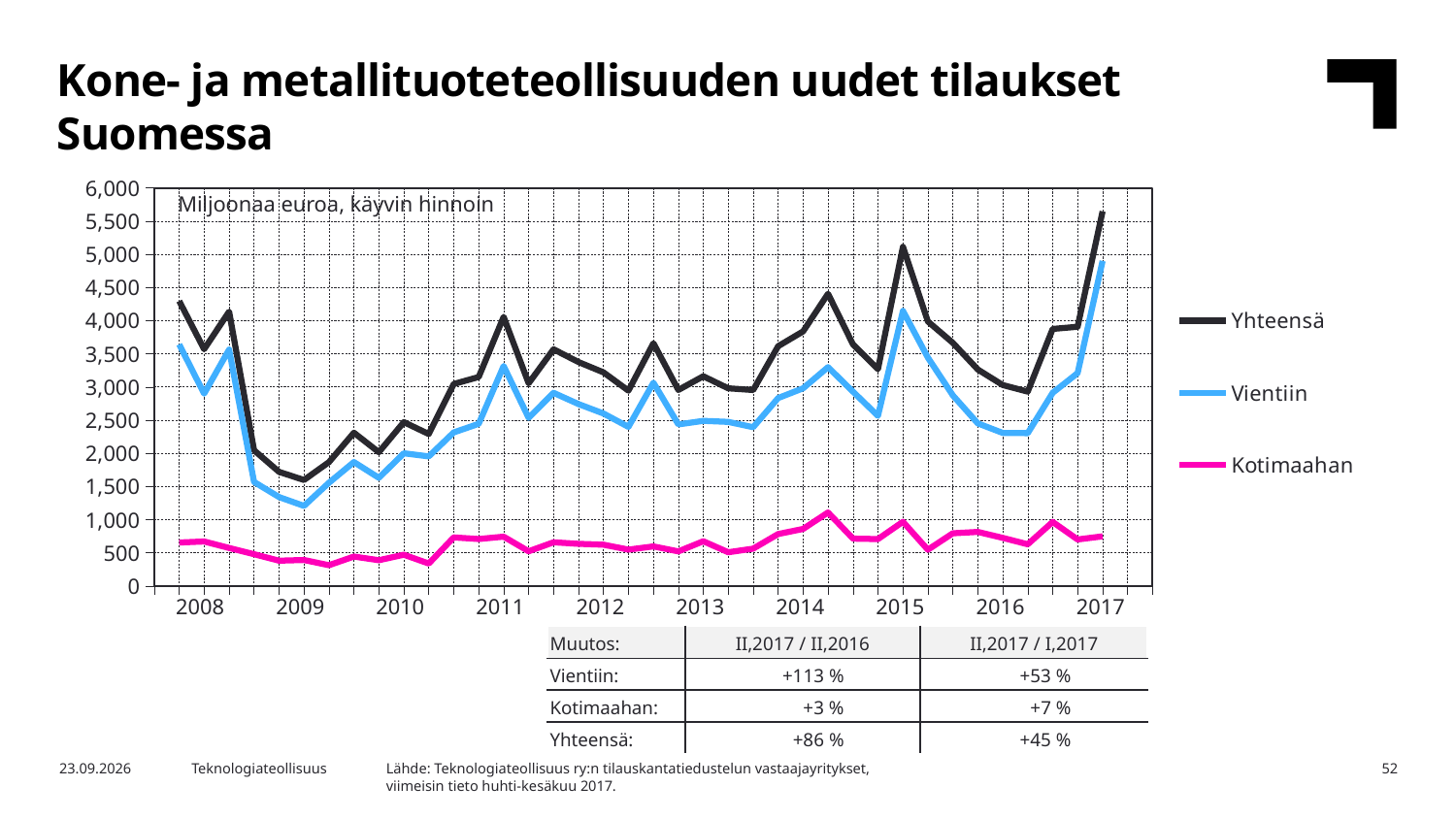
Which series are listed in the legend? Yhteensä, Vientiin, Kotimaahan Is the value of Kotimaahan at any point greater or less than 1,500? less Which series reaches the highest value on the chart? Yhteensä Is the lowest value of Vientiin in 2009 greater or less than 1,500? less Is the value of Yhteensä at the last point in 2017 greater or less than 5,000? greater How many series does the legend list? 3 How many years are labelled on the x axis? 10 What kind of chart is shown on the slide? line chart Which is larger at the end of 2017, Vientiin or Kotimaahan? Vientiin What unit is stated in the chart's annotation text? Miljoonaa euroa, käyvin hinnoin Which series has the lowest values throughout the chart? Kotimaahan Does the Yhteensä line rise or fall from the start of 2008 to the start of 2009? fall